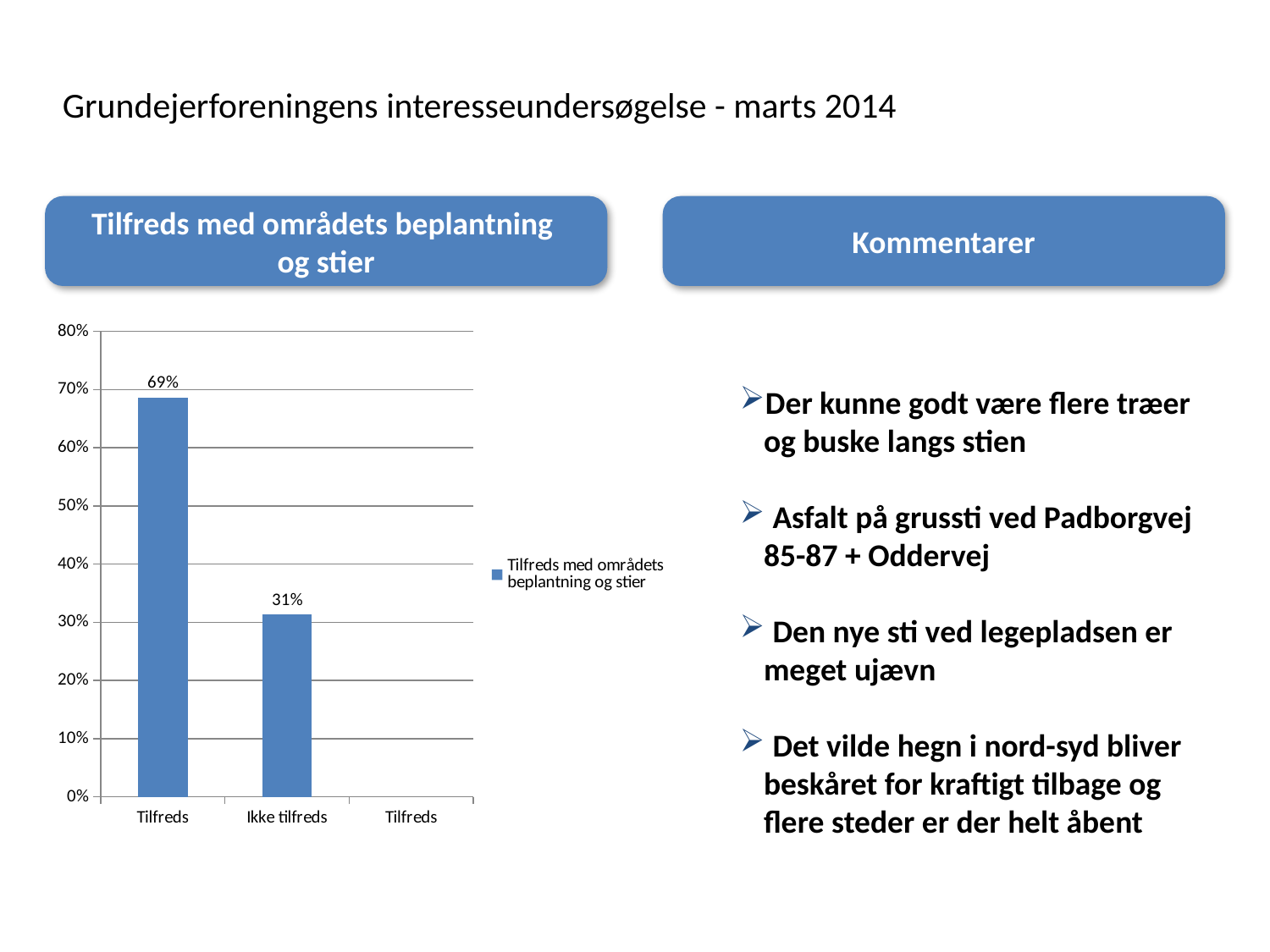
What is the value for Tilfreds? 69% What kind of chart is shown on the slide? Bar chart What is the series name shown in the legend? Tilfreds med områdets beplantning og stier Which is larger, the value for Tilfreds or the value for Ikke tilfreds? Tilfreds Is the value for Ikke tilfreds greater or less than 40%? less What is the difference between the values for Tilfreds and Ikke tilfreds? 38% What is the value for Ikke tilfreds? 31% Which category has the highest value? Tilfreds Which of the plotted bars has the lowest value? Ikke tilfreds How many bars are plotted in the chart? 2 How many series does the legend list? 1 Is the value for Tilfreds greater or less than 60%? greater